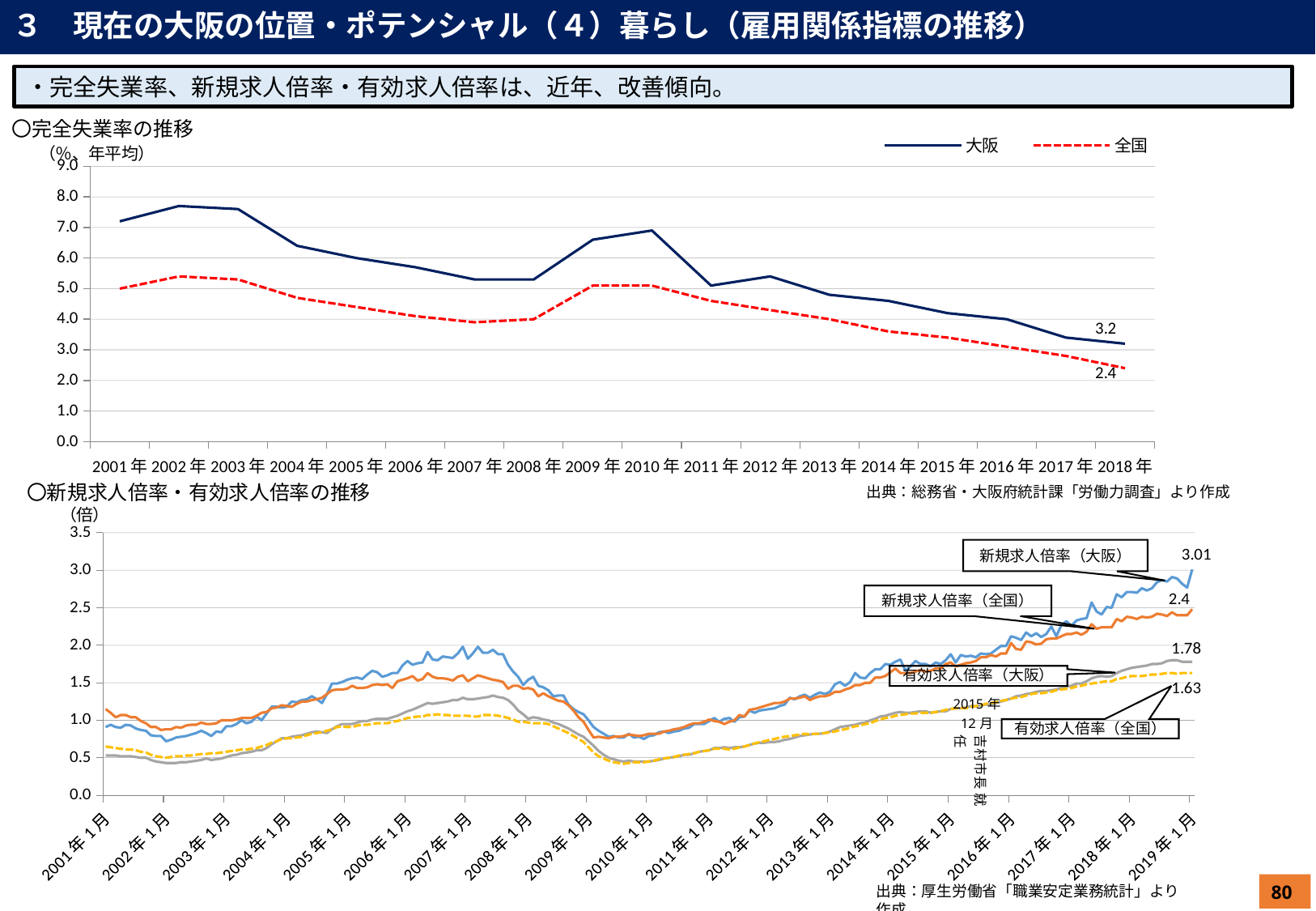
In the top chart (完全失業率の推移), what is the value for 全国 in 2018年? 2.4 What kind of chart is the bottom chart (新規求人倍率・有効求人倍率の推移)? line chart In the bottom chart (新規求人倍率・有効求人倍率の推移), what is the latest labelled value for 新規求人倍率（大阪）? 3.01 In the top chart (完全失業率の推移), how many series does the legend list? 2 In the top chart (完全失業率の推移), what is the value for 大阪 in 2018年? 3.2 In the top chart (完全失業率の推移), does the 大阪 line overall rise or fall from 2001年 to 2018年? fall In the top chart (完全失業率の推移), what is the difference between the 大阪 and 全国 values in 2018年? 0.8 In the top chart (完全失業率の推移), is the value for 大阪 in 2002年 greater or less than 7.0? greater In the bottom chart (新規求人倍率・有効求人倍率の推移), which series has the highest value at the end of the period? 新規求人倍率（大阪） In the top chart (完全失業率の推移), which is higher in 2010年, 大阪 or 全国? 大阪 In the bottom chart (新規求人倍率・有効求人倍率の推移), what is the difference between the latest labelled values for 有効求人倍率（大阪） and 有効求人倍率（全国）? 0.15 In the top chart (完全失業率の推移), how many years are shown on the x axis? 18